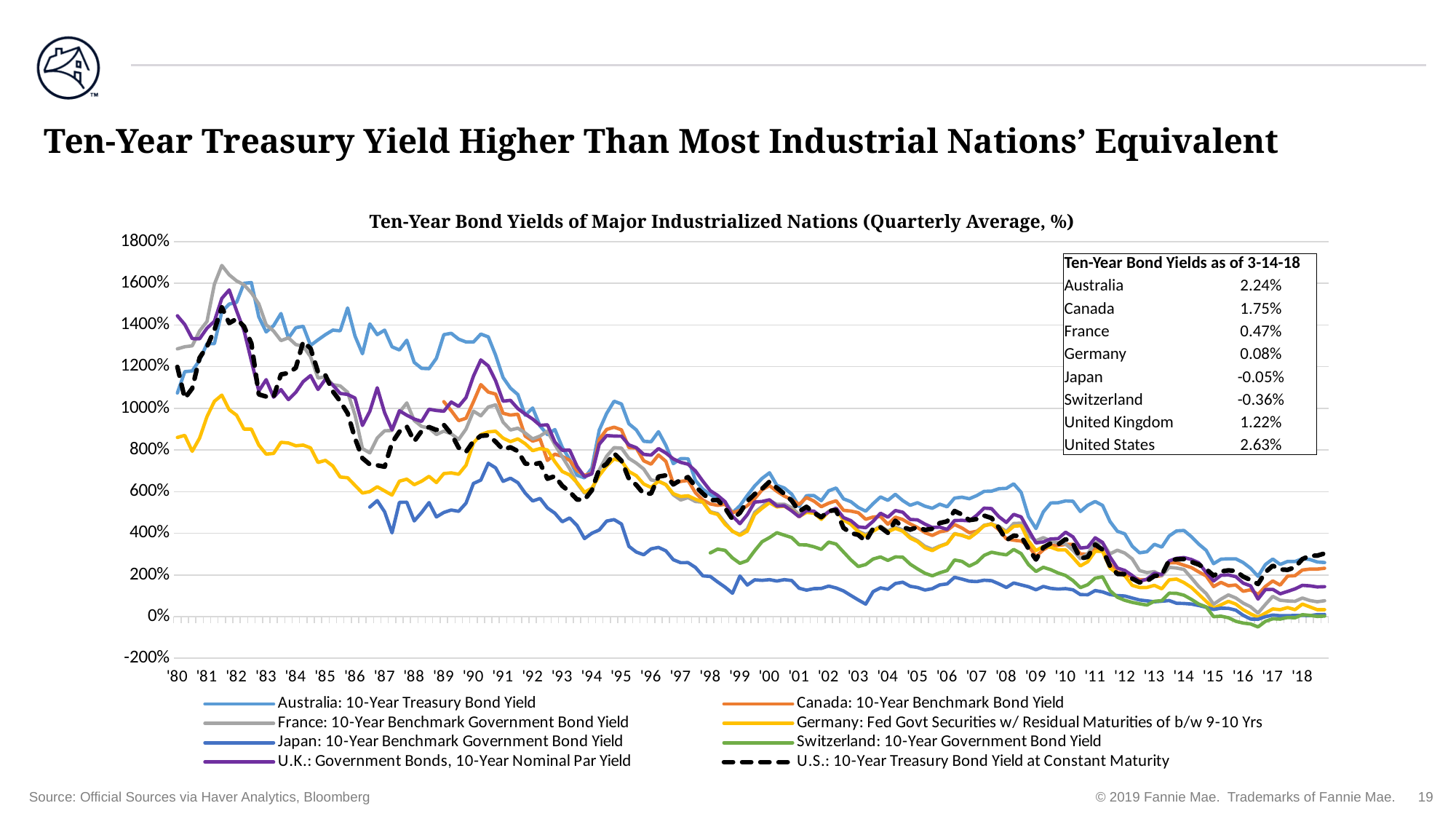
How many series does the chart's legend list? 8 Using the inset table, how much higher is the United States ten-year yield than Australia's as of 3-14-18? 0.39% What is the title of the chart? Ten-Year Bond Yields of Major Industrialized Nations (Quarterly Average, %) In the inset table of yields as of 3-14-18, which country has the highest ten-year bond yield? United States According to the inset table, what is the ten-year bond yield for the United States as of 3-14-18? 2.63% In the inset table of yields as of 3-14-18, which country has the lowest ten-year bond yield? Switzerland Using the inset table, which has the larger ten-year yield as of 3-14-18, France or Germany? France According to the inset table, what is the ten-year bond yield for Japan as of 3-14-18? -0.05% Is the value for Australia's 10-Year Treasury Bond Yield in '82 greater or less than 1400%? greater What kind of chart is shown on the slide? line chart Which series is drawn as a black dashed line? U.S.: 10-Year Treasury Bond Yield at Constant Maturity Overall, does the Australia 10-Year Treasury Bond Yield line rise or fall from '80 to '18? fall